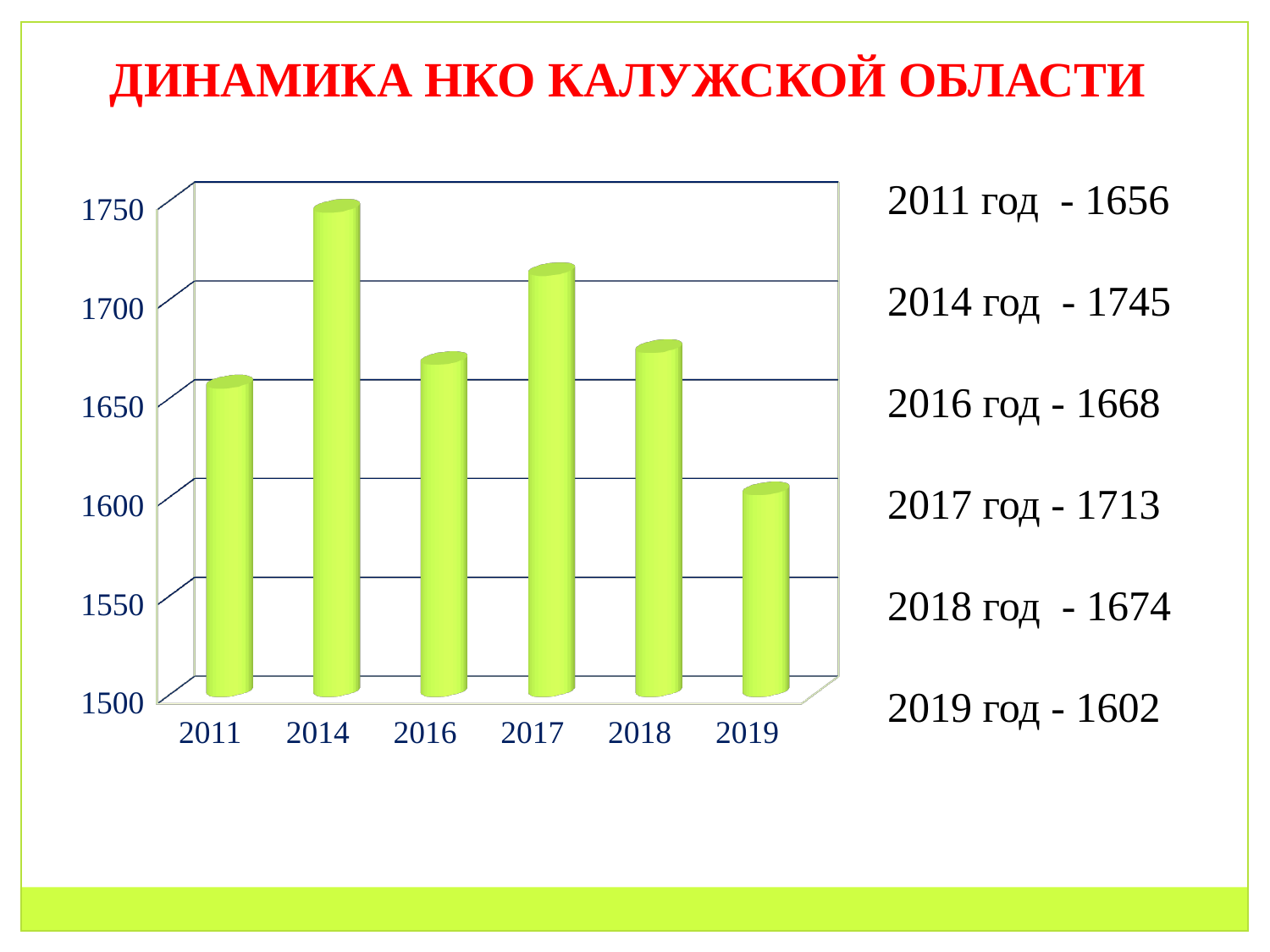
Which year has the lowest value? 2019 What is the value for 2019? 1602 What is the value for 2017? 1713 What kind of chart is shown on the slide? bar chart How many years are shown on the x axis? 6 Which is larger, the value for 2016 or the value for 2018? 2018 What is the value for 2014? 1745 What is the difference between the values for 2014 and 2019? 143 What is the difference between the values for 2017 and 2011? 57 What is the title of the slide? ДИНАМИКА НКО КАЛУЖСКОЙ ОБЛАСТИ Which year has the highest value? 2014 Is the value for 2017 greater or less than 1700? greater